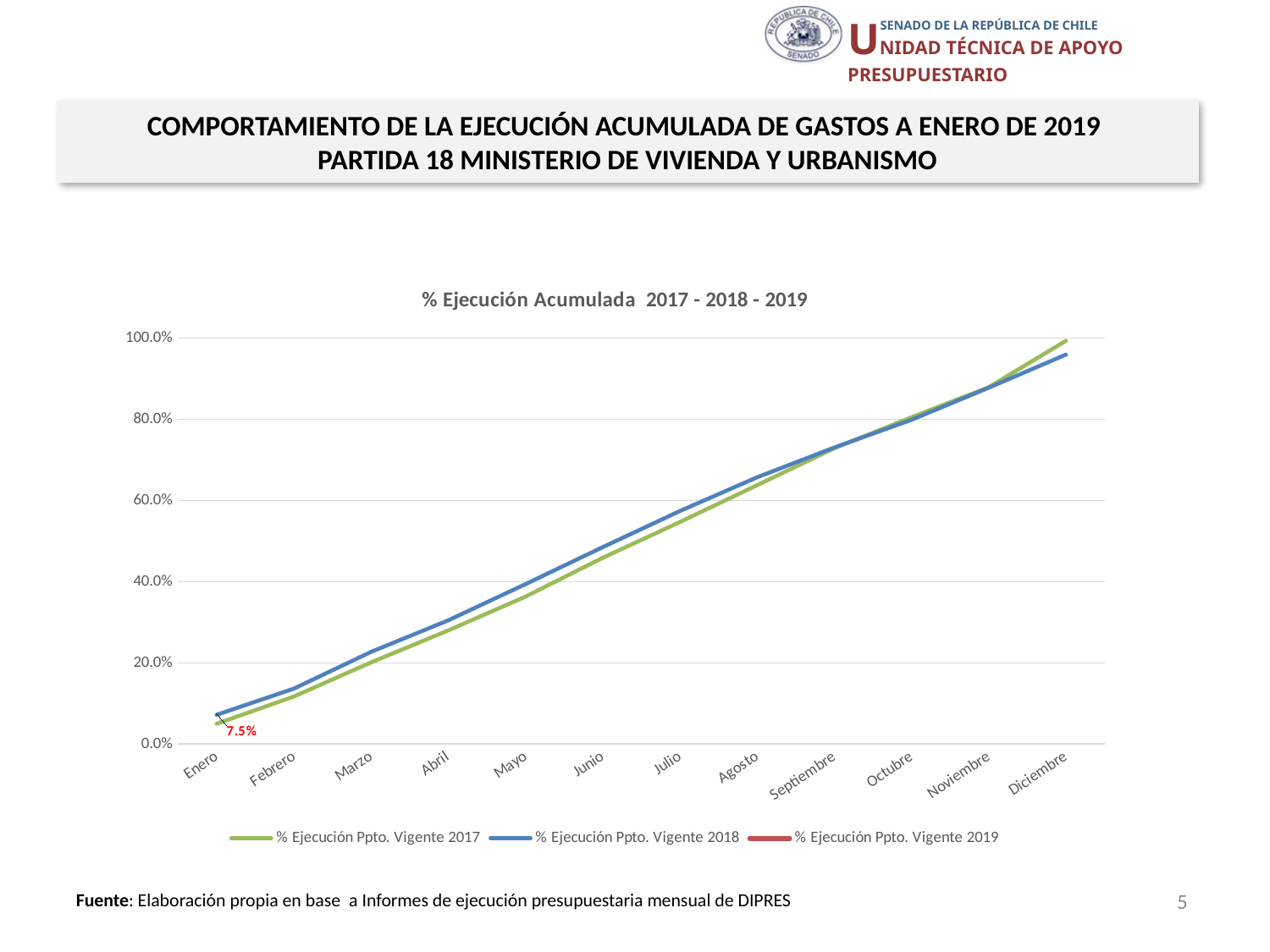
In Diciembre, which series has the higher value: % Ejecución Ppto. Vigente 2017 or % Ejecución Ppto. Vigente 2018? % Ejecución Ppto. Vigente 2017 Is the value for % Ejecución Ppto. Vigente 2018 in Enero greater or less than 20.0%? less In Marzo, which series has the higher value: % Ejecución Ppto. Vigente 2017 or % Ejecución Ppto. Vigente 2018? % Ejecución Ppto. Vigente 2018 Do the values for % Ejecución Ppto. Vigente 2017 rise or fall from Enero to Diciembre? rise Is the value for % Ejecución Ppto. Vigente 2018 in Agosto greater or less than 60.0%? greater In which month does % Ejecución Ppto. Vigente 2018 reach its highest value? Diciembre What is the labelled value for % Ejecución Ppto. Vigente 2019 in Enero? 7.5% How many months are shown along the x axis of the chart? 12 What is the title of the chart? % Ejecución Acumulada 2017 - 2018 - 2019 Is the value for % Ejecución Ppto. Vigente 2017 in Diciembre greater or less than 80.0%? greater How many series does the chart legend list? 3 What kind of chart is shown on the slide? line chart